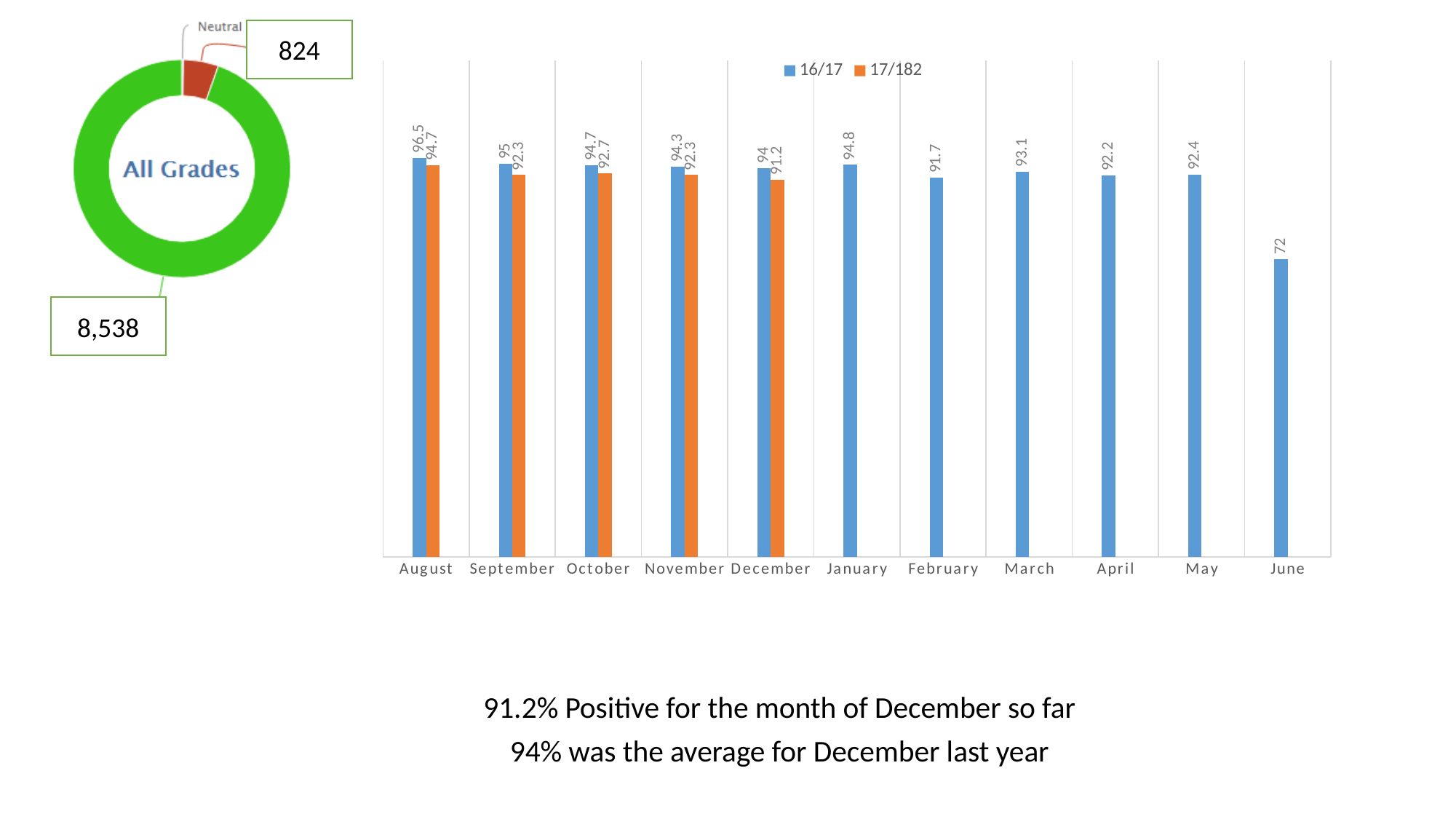
How many months are shown on the x axis of the bar chart? 11 In the bar chart, which month has the lowest 16/17 value? June In the All Grades donut chart, what is the value of the green segment? 8,538 In the bar chart, which is larger for October: the 16/17 value or the 17/182 value? 16/17 What kind of chart is the chart on the right of the slide? Bar chart How many series does the legend of the bar chart list? 2 In the bar chart, which month has the highest 16/17 value? August In the bar chart, what is the 17/182 value for December? 91.2 In the All Grades donut chart, what is the value of the Neutral slice? 824 In the bar chart, what is the 16/17 value for August? 96.5 In the bar chart, what is the 16/17 value for June? 72 In the bar chart, what is the difference between the 16/17 and 17/182 values for December? 2.8